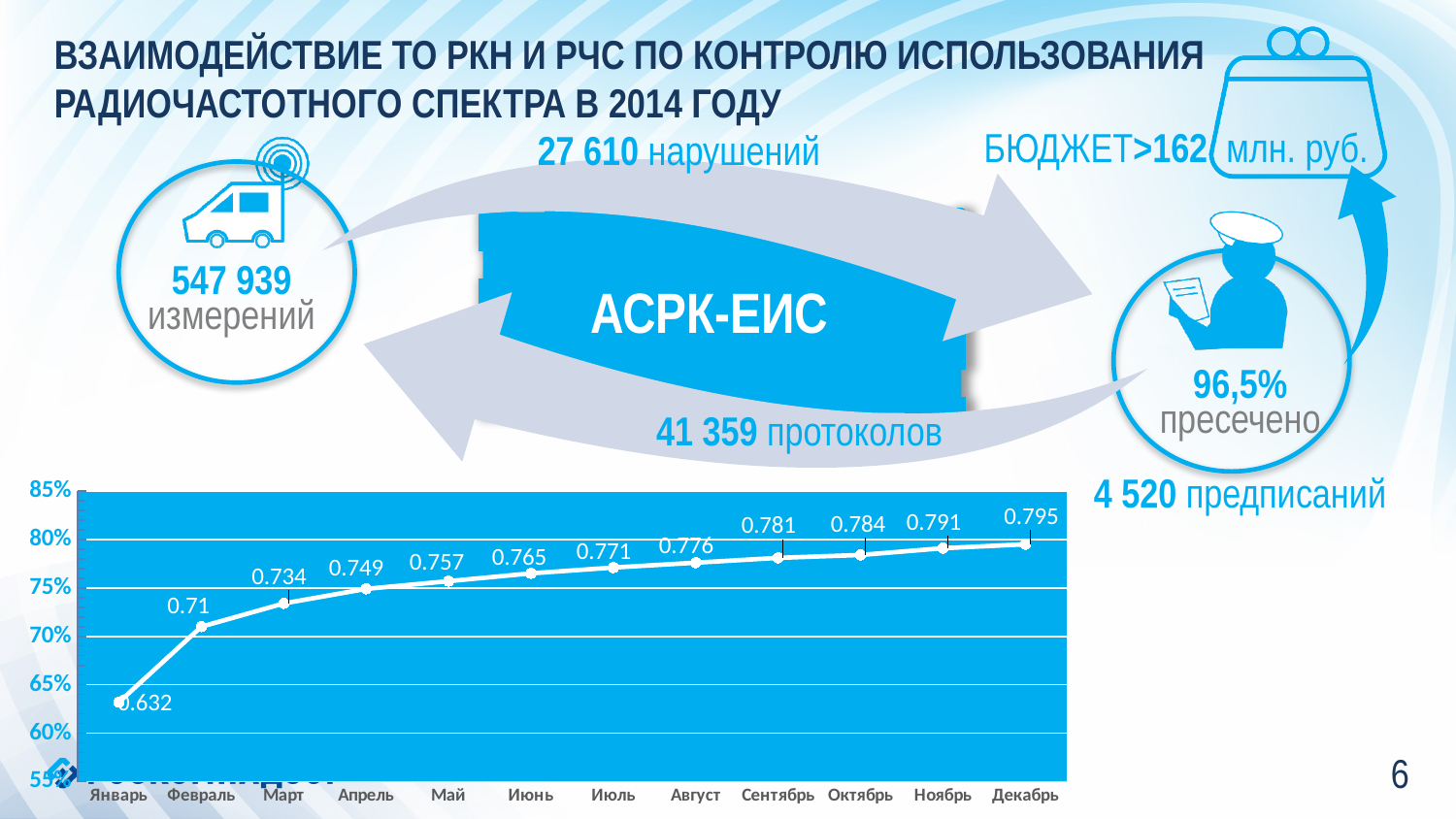
Which is larger on the line chart, the value for Март or the value for Май? Май Is the value for Январь on the line chart greater or less than 65%? less What is the difference between the values for Февраль and Январь on the line chart? 0.078 What is the value for Декабрь (December) on the line chart? 0.795 What is the difference between the values for Декабрь and Январь on the line chart? 0.163 Which month has the highest value on the line chart? Декабрь Do the values on the line chart rise or fall from Январь to Декабрь? rise What is the value for Июнь (June) on the line chart? 0.765 What type of chart is shown at the bottom of the slide? line chart Which month has the lowest value on the line chart? Январь How many months (data points) are plotted on the line chart? 12 What is the value for Январь (January) on the line chart? 0.632